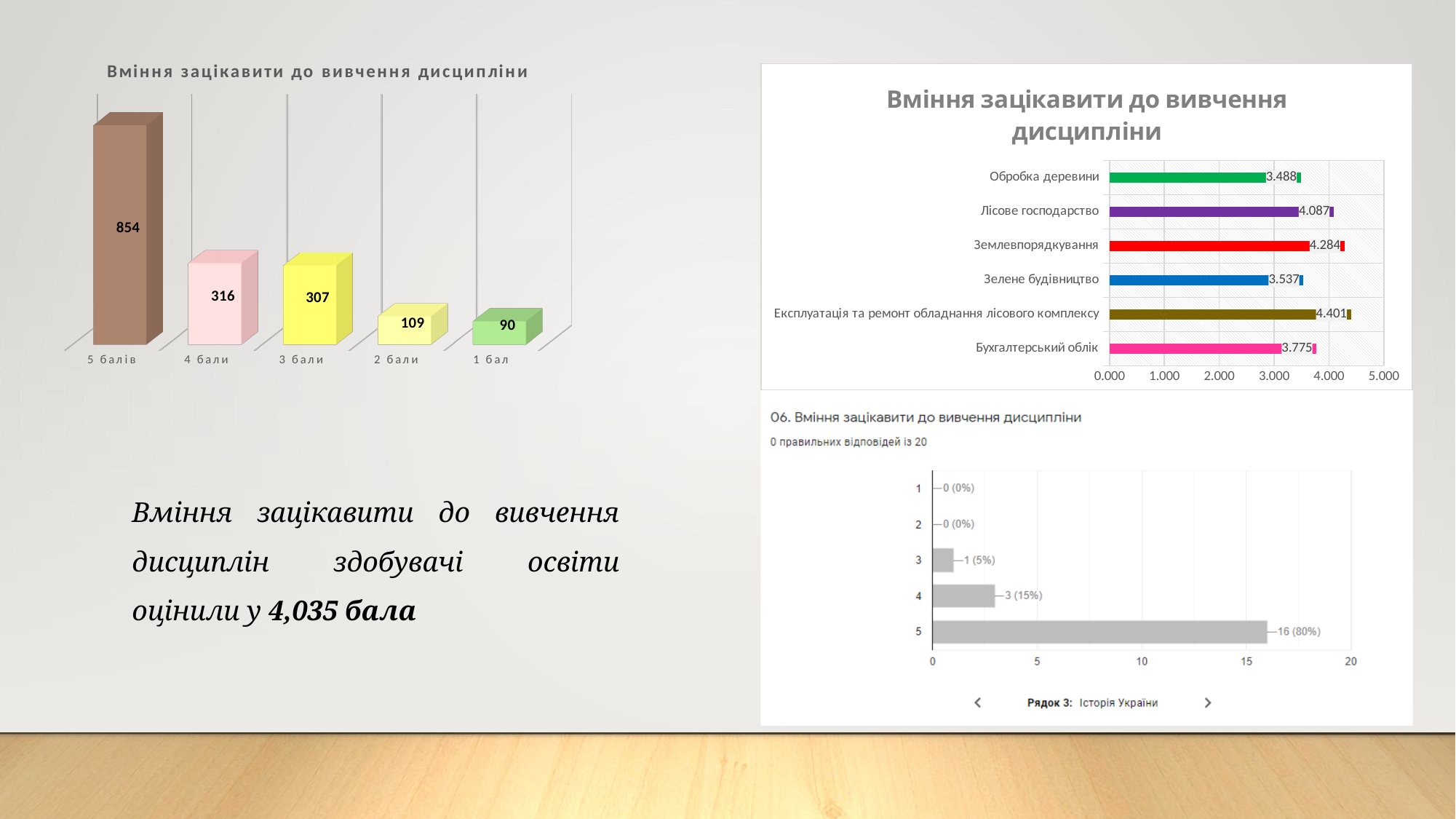
On the left chart, do the values rise or fall from '5 балів' to '1 бал'? fall On the left chart, which category has the lowest value? 1 бал On the left chart, what is the difference between the values for '4 бали' and '3 бали'? 9 On the bottom-right chart, what is the value for category '5'? 16 (80%) On the top-right chart, which category has the highest value? Експлуатація та ремонт обладнання лісового комплексу On the top-right chart, which category has the lowest value? Обробка деревини On the top-right chart, what is the value for 'Лісове господарство'? 4.087 On the top-right chart, which is larger: the value for 'Землевпорядкування' or 'Бухгалтерський облік'? Землевпорядкування On the left chart, how many categories are shown? 5 On the top-right chart, what kind of chart is it? bar chart On the left chart, what is the value for '5 балів'? 854 On the bottom-right chart, what is the value for category '4'? 3 (15%)